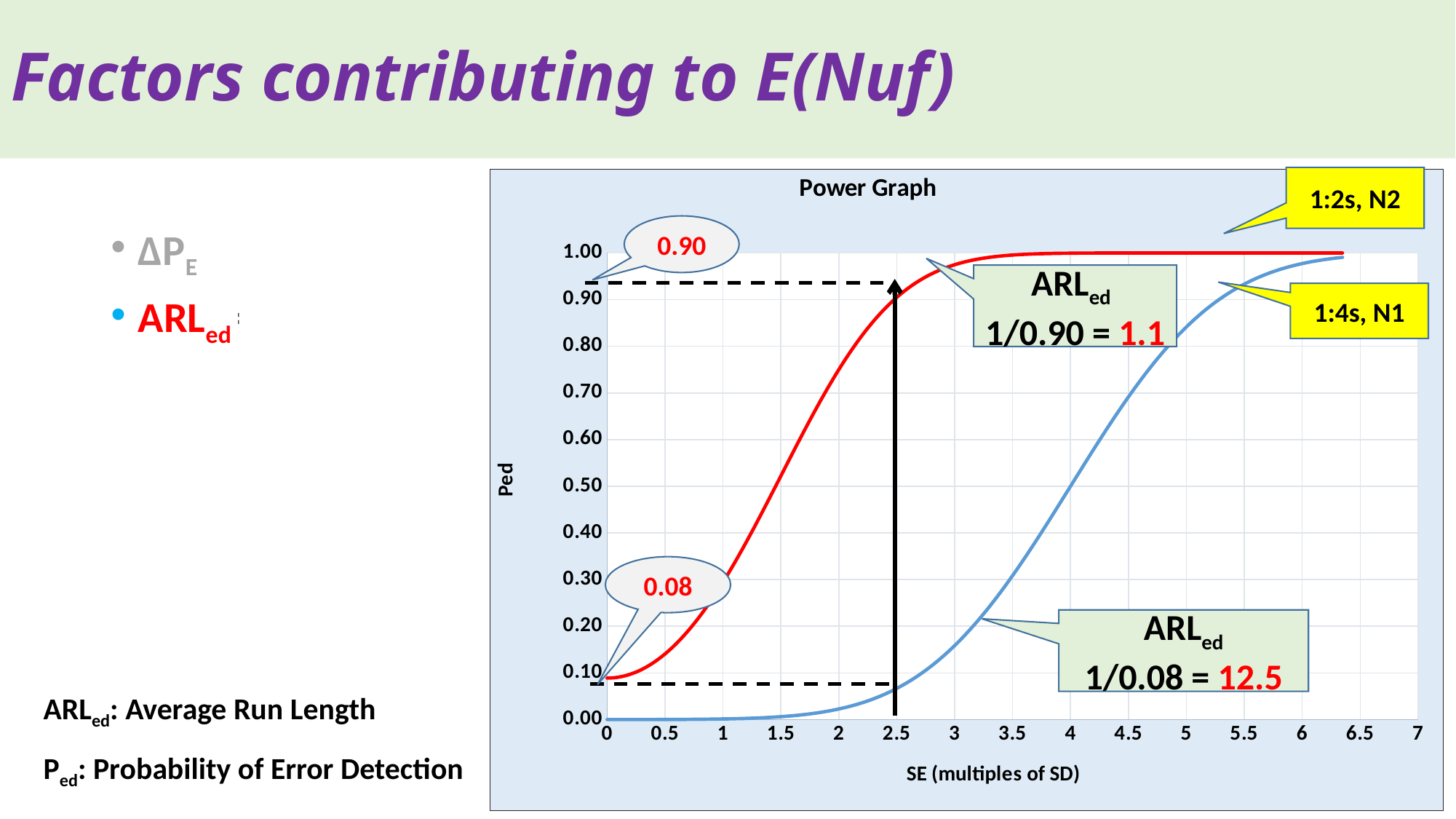
What kind of chart is the Power Graph? line chart Is the Ped value of the 1:4s, N1 curve at SE = 3.5 greater or less than 0.50? less Is the Ped value of the 1:2s, N2 curve at SE = 2 greater or less than 0.50? greater At SE = 2.5, which curve has the higher Ped, 1:2s, N2 or 1:4s, N1? 1:2s, N2 According to the callout, what is the Ped value of the 1:4s, N1 curve at SE = 2.5? 0.08 According to the callout, what is the Ped value of the 1:2s, N2 curve at SE = 2.5? 0.90 What ARLed value is shown for the 1:4s, N1 curve (1/0.08)? 12.5 Do the Ped values of the curves rise or fall as SE increases? rise What ARLed value is shown for the 1:2s, N2 curve (1/0.90)? 1.1 What is the title of the chart? Power Graph How many curves are plotted on the Power Graph? 2 What is the label of the x axis of the Power Graph? SE (multiples of SD)